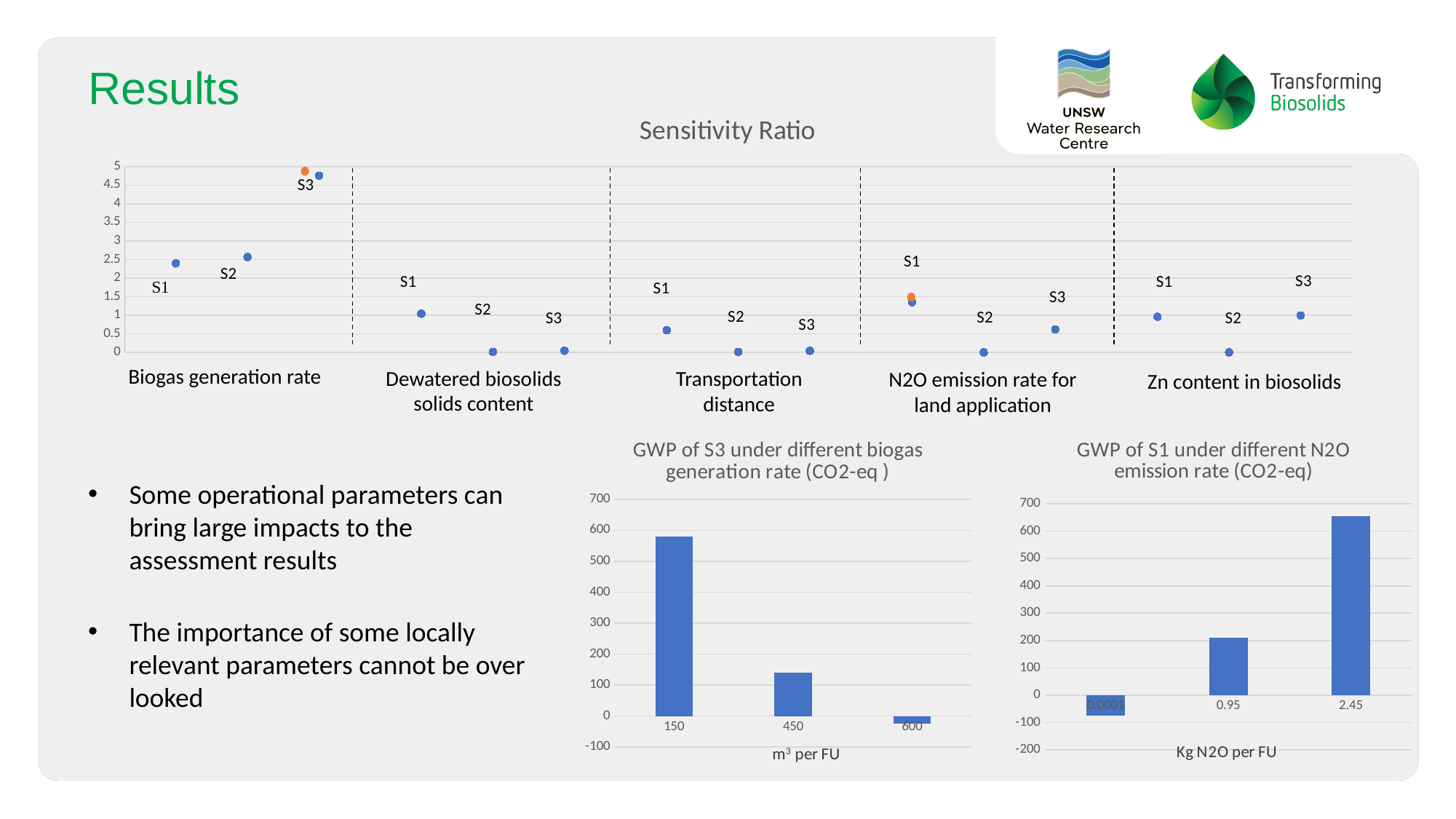
In the 'GWP of S1 under different N2O emission rate (CO2-eq)' chart, which category has the highest value? 2.45 In the 'GWP of S3 under different biogas generation rate (CO2-eq)' chart, which category has the lowest value? 600 In the 'GWP of S3 under different biogas generation rate (CO2-eq)' chart, is the value for 150 greater or less than 500? greater In the 'GWP of S3 under different biogas generation rate (CO2-eq)' chart, do the values rise or fall as the biogas generation rate increases from 150 to 600? fall What kind of chart is the 'GWP of S3 under different biogas generation rate (CO2-eq)' chart? bar chart In the 'Sensitivity Ratio' chart, which parameter group contains the highest plotted point? Biogas generation rate In the 'GWP of S1 under different N2O emission rate (CO2-eq)' chart, is the value for 0.0001 greater or less than 0? less In the 'GWP of S1 under different N2O emission rate (CO2-eq)' chart, do the values rise or fall as the N2O emission rate increases from 0.0001 to 2.45? rise In the 'GWP of S3 under different biogas generation rate (CO2-eq)' chart, how many bars are plotted? 3 In the 'GWP of S3 under different biogas generation rate (CO2-eq)' chart, which category has the highest value? 150 In the 'GWP of S1 under different N2O emission rate (CO2-eq)' chart, is the value for 2.45 greater or less than 600? greater